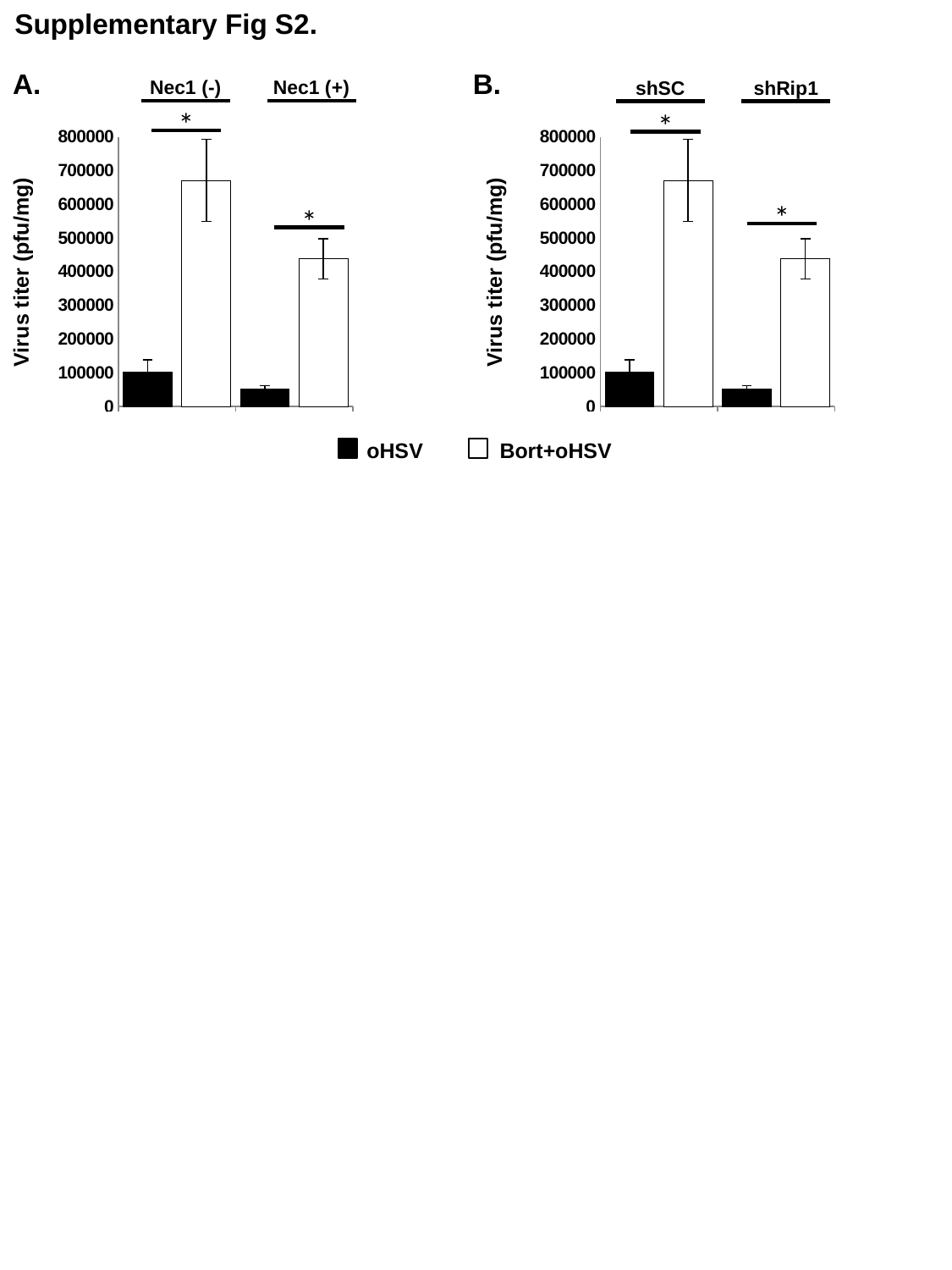
In chart A, what kind of chart is shown? bar chart In chart B, is the Bort+oHSV value for shSC greater or less than 600000? greater In chart A, is the Bort+oHSV value for Nec1 (+) greater or less than 500000? less In chart B, for shRip1, which is larger, the oHSV bar or the Bort+oHSV bar? Bort+oHSV In chart B, is the oHSV value for shRip1 greater or less than 100000? less In chart A, which group has the higher Bort+oHSV bar, Nec1 (-) or Nec1 (+)? Nec1 (-) In chart B, how many groups are shown on the x axis? 2 In chart B, what is the y-axis title? Virus titer (pfu/mg) In chart A, how many series does the legend list? 2 In chart A, what are the two series named in the legend? oHSV and Bort+oHSV